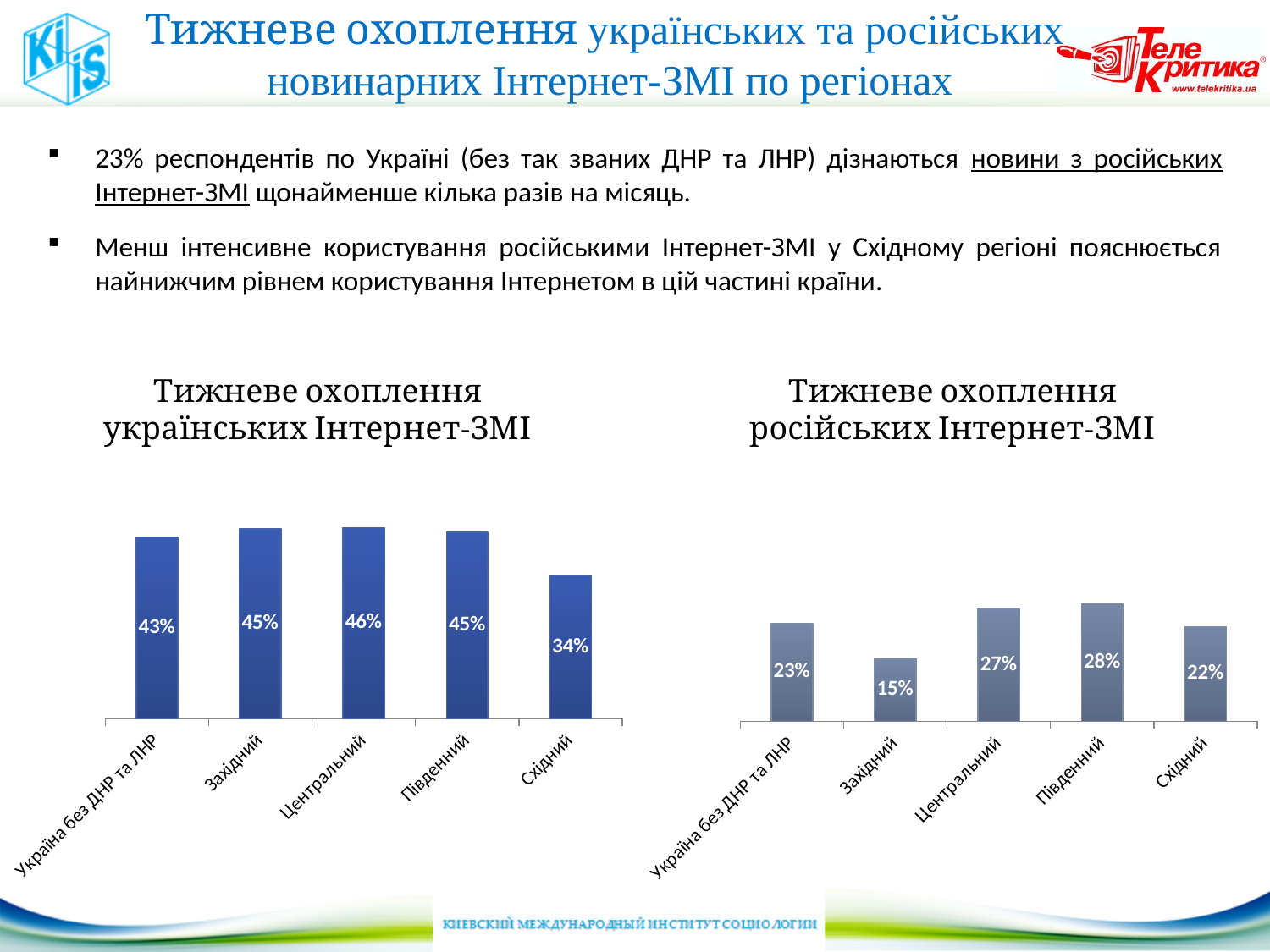
In the chart 'Тижневе охоплення російських Інтернет-ЗМІ', what is the difference between the values for Південний and Західний? 13% In the chart 'Тижневе охоплення українських Інтернет-ЗМІ', what is the value for Західний? 45% In the chart 'Тижневе охоплення російських Інтернет-ЗМІ', which is larger: the value for Україна без ДНР та ЛНР or the value for Центральний? Центральний In the chart 'Тижневе охоплення українських Інтернет-ЗМІ', what is the difference between the values for Центральний and Східний? 12% How many categories are shown in the chart 'Тижневе охоплення українських Інтернет-ЗМІ'? 5 In the chart 'Тижневе охоплення українських Інтернет-ЗМІ', which category has the lowest value? Східний What is the title of the chart on the left side of the slide? Тижневе охоплення українських Інтернет-ЗМІ What kind of chart is 'Тижневе охоплення російських Інтернет-ЗМІ'? Bar chart In the chart 'Тижневе охоплення українських Інтернет-ЗМІ', which category has the highest value? Центральний In the chart 'Тижневе охоплення російських Інтернет-ЗМІ', which category has the highest value? Південний In the chart 'Тижневе охоплення російських Інтернет-ЗМІ', which category has the lowest value? Західний In the chart 'Тижневе охоплення російських Інтернет-ЗМІ', what is the value for Східний? 22%